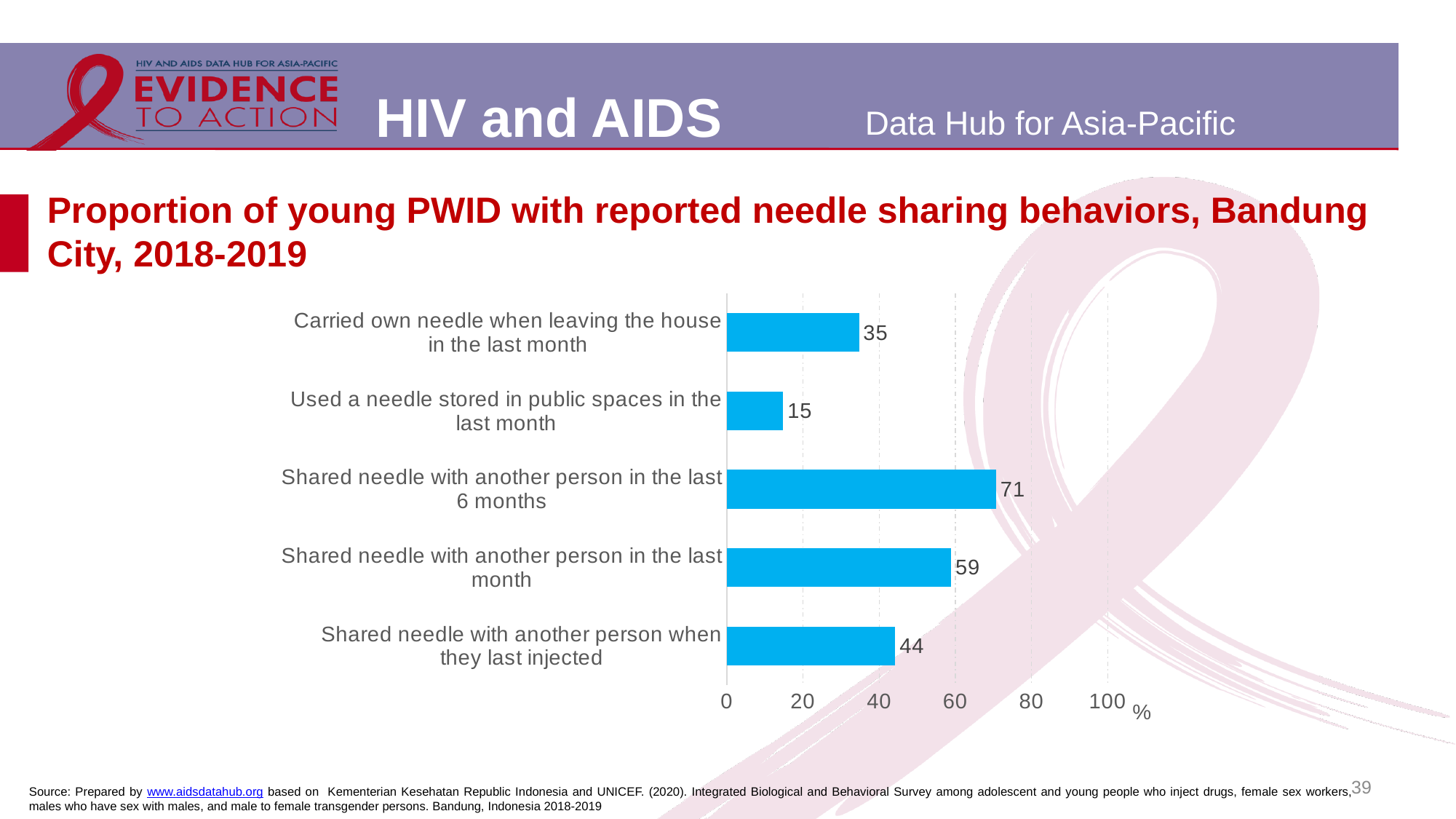
Which needle sharing behavior has the highest reported proportion? Shared needle with another person in the last 6 months What proportion of young PWID carried their own needle when leaving the house in the last month? 35 Which is larger: the proportion who shared a needle with another person when they last injected, or the proportion who carried their own needle when leaving the house in the last month? Shared needle with another person when they last injected What is the value for 'Used a needle stored in public spaces in the last month'? 15 Is the value for 'Shared needle with another person in the last month' greater or less than 40? greater How many needle sharing behaviors are shown in the chart? 5 What is the difference between the proportion who shared a needle in the last 6 months and the proportion who shared a needle in the last month? 12 What percentage of young PWID shared a needle with another person in the last 6 months? 71 What unit is shown at the end of the horizontal axis? % What is the difference between the proportion who shared a needle when they last injected and the proportion who used a needle stored in public spaces in the last month? 29 Which behavior has the lowest reported proportion? Used a needle stored in public spaces in the last month What type of chart is used on this slide? Bar chart